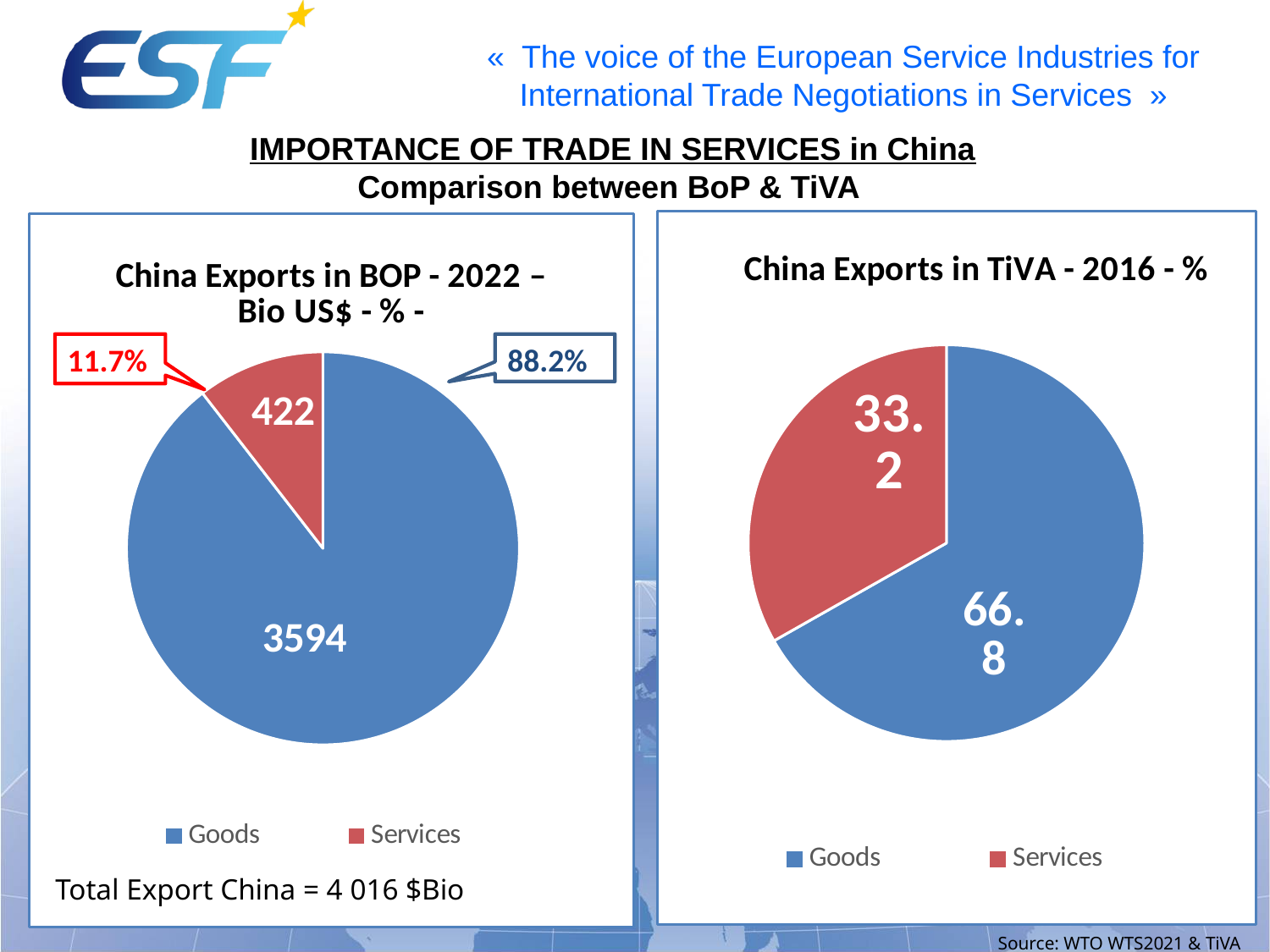
In the 'China Exports in BOP - 2022' chart, what percentage share does Goods have? 88.2% In the 'China Exports in TiVA - 2016' chart, what is the value for Services? 33.2 How many categories does the legend of the 'China Exports in BOP - 2022' chart list? 2 In the 'China Exports in TiVA - 2016' chart, what is the value for Goods? 66.8 What kind of chart is the 'China Exports in TiVA - 2016' chart? Pie chart In the 'China Exports in BOP - 2022' chart, what percentage share does Services have? 11.7% In the 'China Exports in BOP - 2022' chart, what is the difference between the Goods and Services values? 3172 In the 'China Exports in TiVA - 2016' chart, what is the difference between the Goods and Services values? 33.6 In the 'China Exports in BOP - 2022' chart, what is the value for Services? 422 In the 'China Exports in BOP - 2022' chart, which category is the smallest? Services In the 'China Exports in BOP - 2022' chart, what is the value for Goods? 3594 In the 'China Exports in TiVA - 2016' chart, which category is the largest? Goods